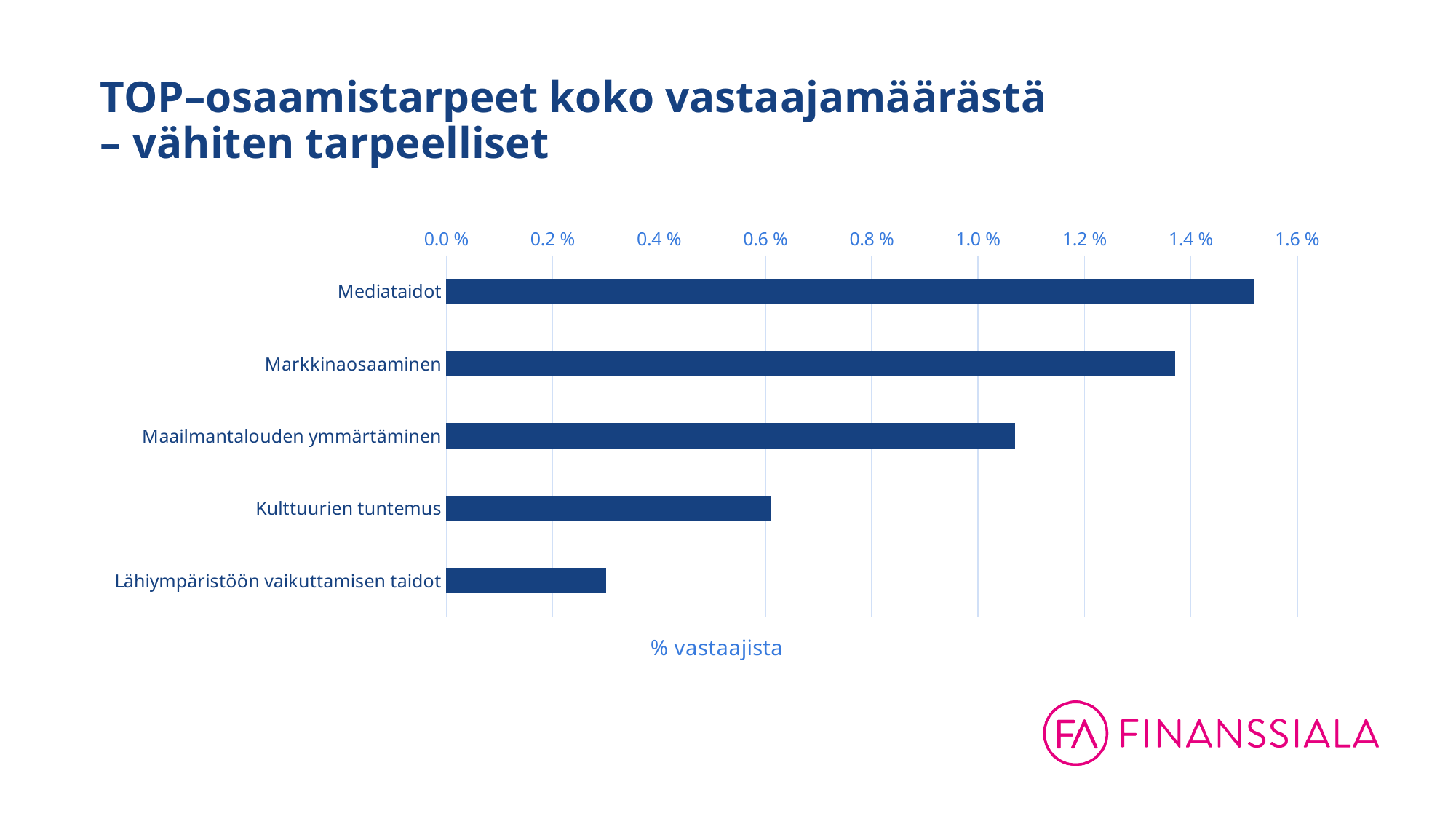
Is the value for Mediataidot greater or less than 1.4 %? greater Is the value for Maailmantalouden ymmärtäminen greater or less than 0.8 %? greater What is the title of the slide? TOP–osaamistarpeet koko vastaajamäärästä – vähiten tarpeelliset Which category has the lowest value in the chart? Lähiympäristöön vaikuttamisen taidot Is the value for Markkinaosaaminen greater or less than 1.2 %? greater How many categories are plotted in the chart? 5 Which category has the highest value in the chart? Mediataidot What kind of chart is shown on the slide? bar chart What is the label of the horizontal axis of the chart? % vastaajista Which is larger, the value for Kulttuurien tuntemus or the value for Maailmantalouden ymmärtäminen? Maailmantalouden ymmärtäminen